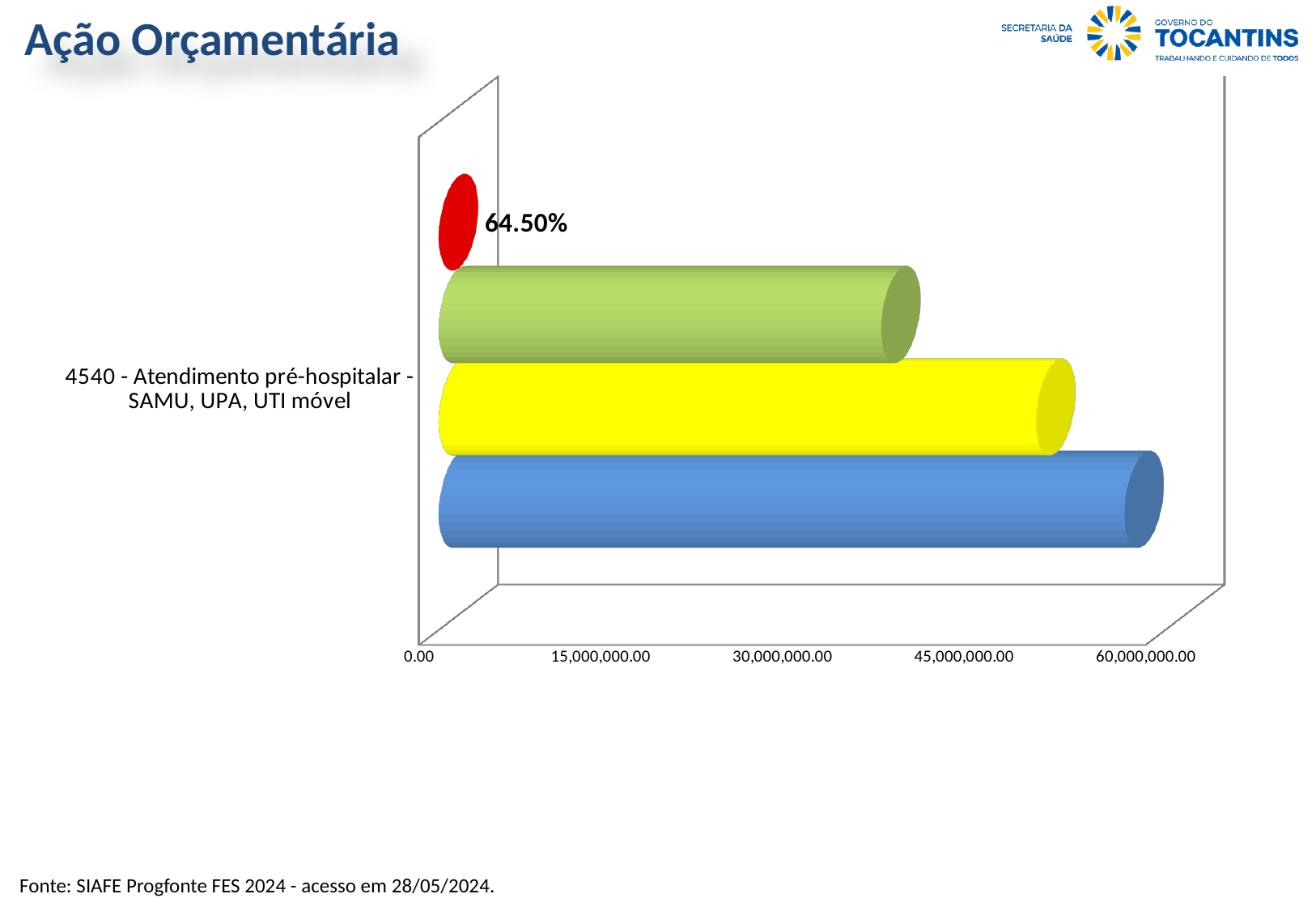
What value is printed as a data label next to the red bar? 64.50% Which coloured bar is the longest on the chart? blue What is the highest tick value shown on the horizontal axis? 60,000,000.00 Which coloured bar is the shortest on the chart? red Is the value of the yellow bar greater or less than 45,000,000.00? greater Is the yellow bar longer or shorter than the green bar? longer Is the value of the green bar greater or less than 45,000,000.00? less Is the value of the green bar greater or less than 30,000,000.00? greater How many categories are shown on the chart's vertical axis? 1 What is the category label shown on the chart? 4540 - Atendimento pré-hospitalar - SAMU, UPA, UTI móvel What is the title of the slide containing the chart? Ação Orçamentária What kind of chart is shown on the slide? bar chart